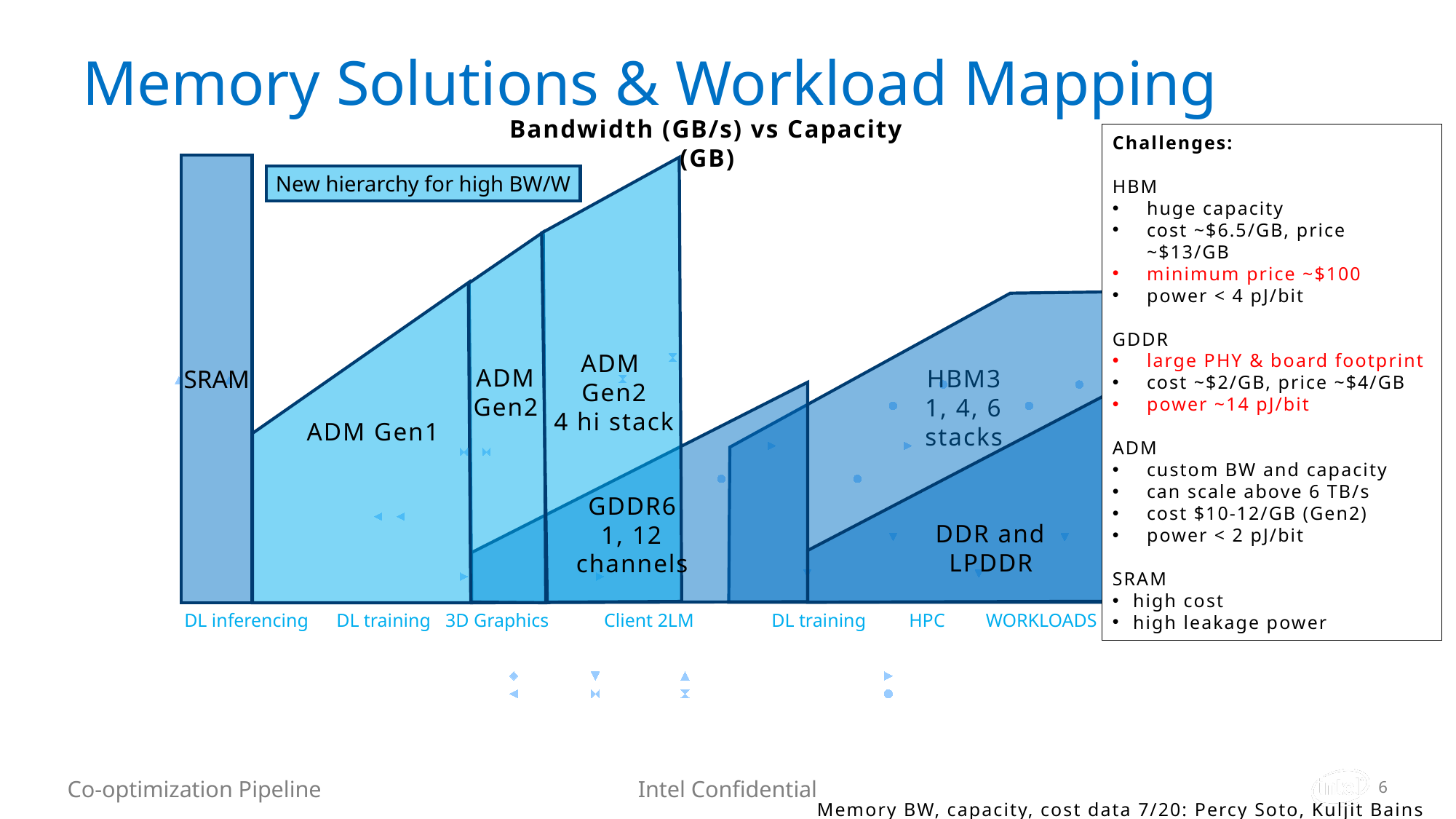
What is the title of the chart on the slide? Bandwidth (GB/s) vs Capacity (GB) Which region reaches a higher bandwidth on the chart, ADM Gen2 4 hi stack or GDDR6? ADM Gen2 4 hi stack Which region reaches a higher bandwidth on the chart, SRAM or DDR and LPDDR? SRAM Which memory type is shown in the leftmost region of the chart? SRAM Which region reaches a higher bandwidth on the chart, HBM3 or GDDR6? HBM3 How many labelled memory regions are shown in the chart? 7